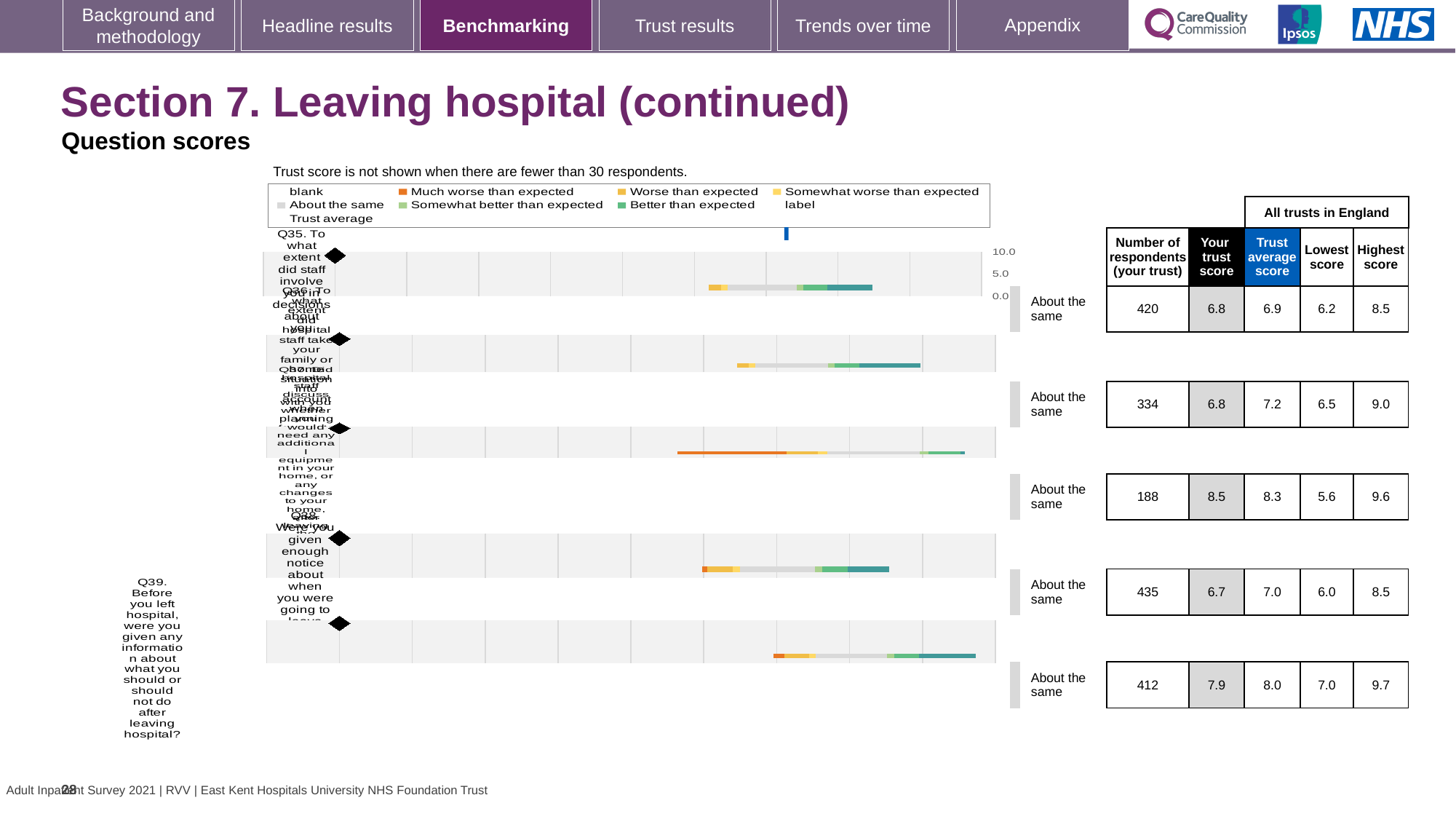
What kind of chart is used to show the question scores on this slide? bar chart What is the trust score for Q39 (information about what you should or should not do after leaving hospital)? 7.9 What benchmark category is shown for Q38 (enough notice about when you were going to leave hospital)? About the same What is the number of respondents for Q37 (additional equipment or changes to your home)? 188 What is the highest score across all trusts in England for Q39? 9.7 What is the maximum value shown on the score axis of the chart? 10.0 Is the trust score for Q35 larger or smaller than the trust average score for Q35? smaller How many questions (Q35 to Q39) are plotted in the chart? 5 What is the difference between the highest score (9.6) and the lowest score (5.6) for Q37? 4.0 Which question has the highest trust score for this trust? Q37 What is the trust average score for Q36 (family or home situation taken into account)? 7.2 Which question has the lowest trust score for this trust? Q38